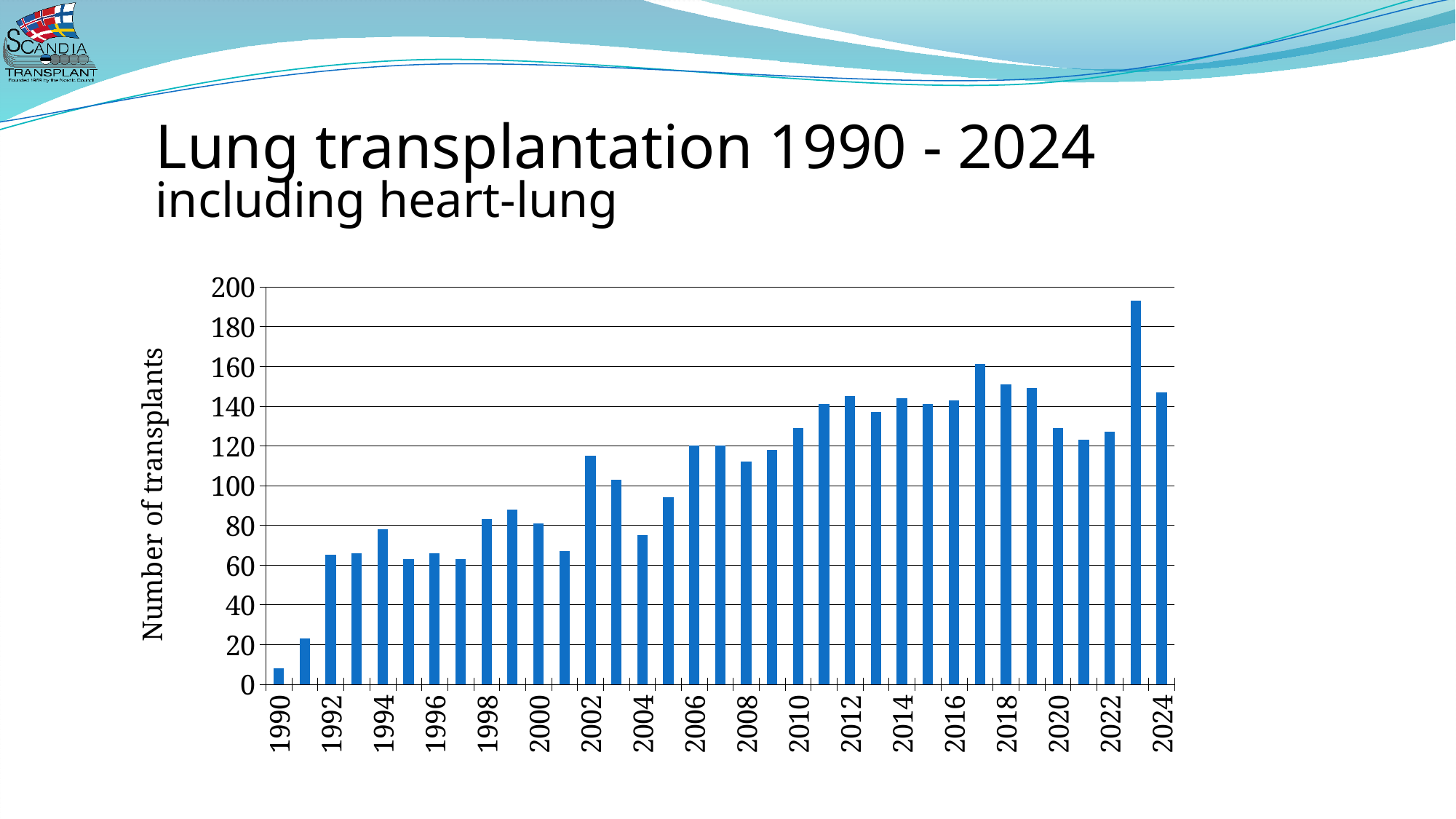
Is the value for 2023 greater or less than 180? greater Which year has the highest number of transplants? 2023 Is the value for 2002 greater or less than 100? greater Which year has the lowest number of transplants? 1990 Is the value for 1990 greater or less than 20? less How many years (bars) are plotted in the chart? 35 Which year has the larger value, 2023 or 2024? 2023 Overall, do the values rise or fall from 1990 to 2024? rise What is the label on the vertical axis of the chart? Number of transplants Which year has the larger value, 1991 or 1992? 1992 What kind of chart is shown on the slide? bar chart